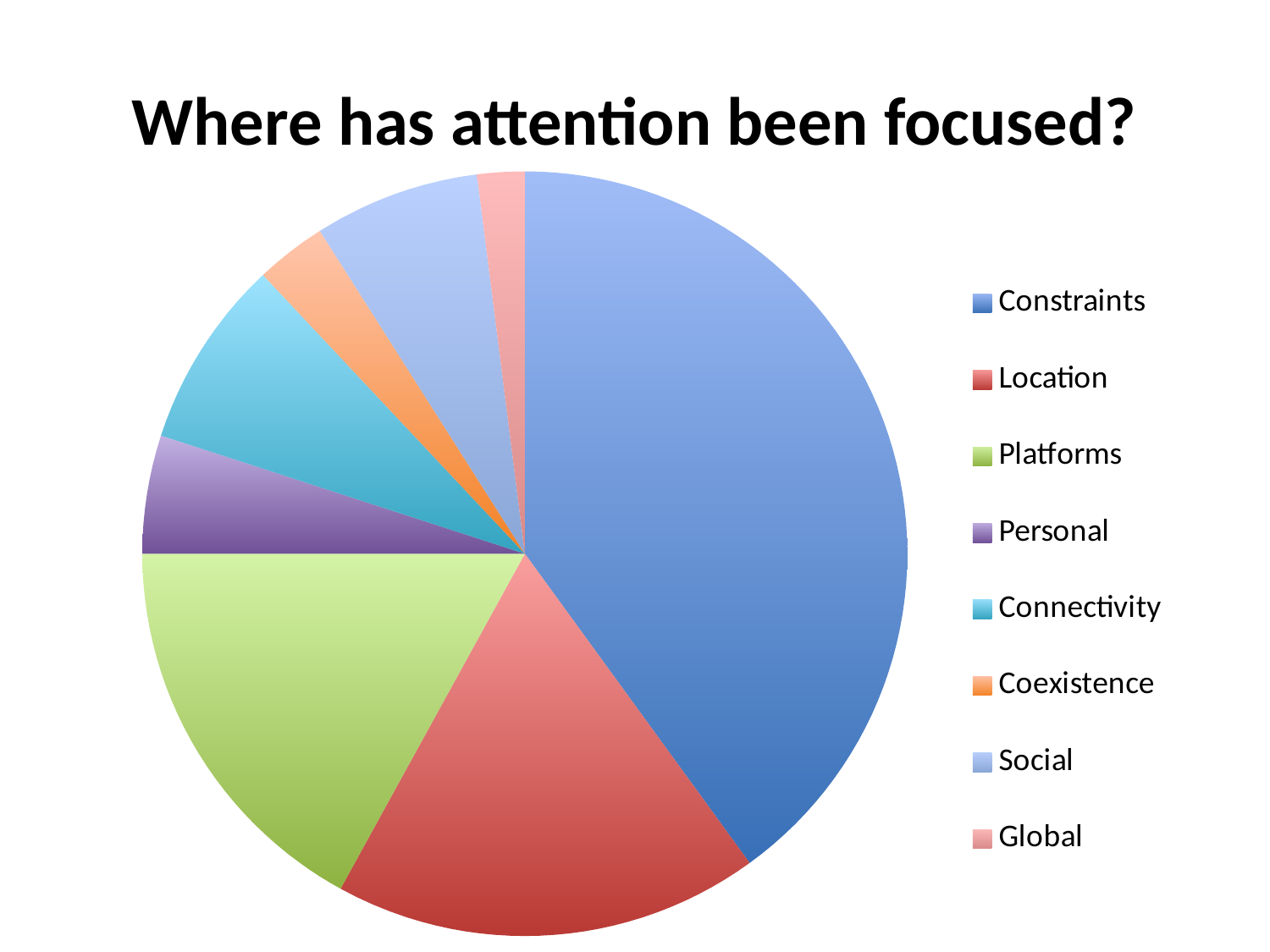
How many entries does the legend list? 8 Which slice is larger, Connectivity or Coexistence? Connectivity Which category is shown in green in the legend? Platforms Which category has the largest slice of the pie? Constraints What is the title of the chart? Where has attention been focused? Which category has the smallest slice of the pie? Global Which slice is larger, Platforms or Personal? Platforms How many slices does the pie chart have? 8 What kind of chart is shown on the slide? Pie chart Which slice is larger, Constraints or Location? Constraints